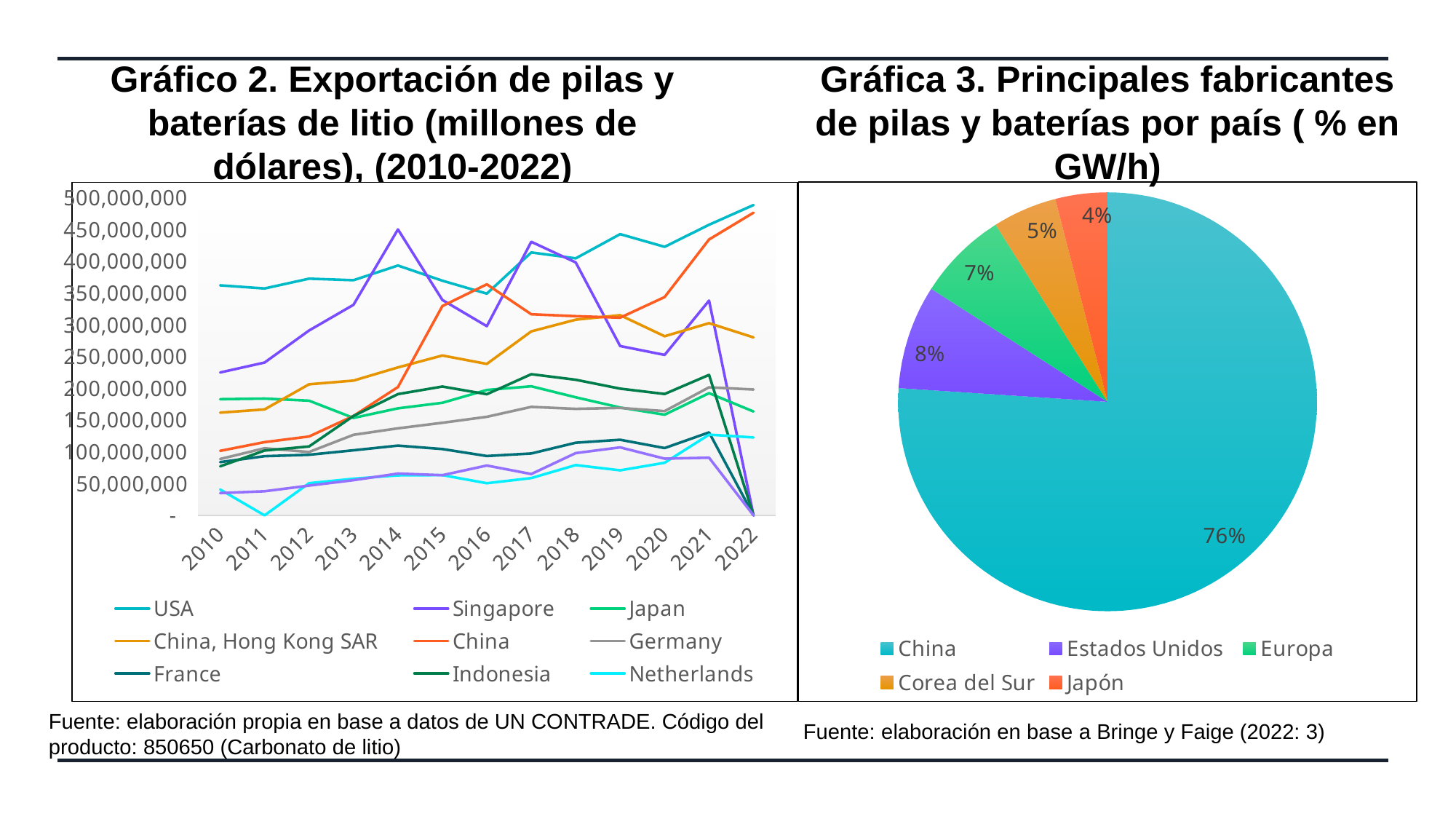
In Gráfica 3, which country has the smallest slice? Japón How many slices does the pie chart in Gráfica 3 have? 5 In Gráfico 2, is the value for Netherlands in 2011 greater or less than 50,000,000? less In Gráfico 2, is the value for USA in 2010 greater or less than 300,000,000? greater In Gráfica 3, what share of the pie does China hold? 76% How many series does the legend of Gráfico 2 list? 9 In Gráfico 2, which country has the highest value in 2010? USA In Gráfica 3, what is the difference in percentage points between China and Estados Unidos? 68 In Gráfica 3, what percentage is shown for Estados Unidos? 8% In Gráfica 3, which is larger, the share for Europa or for Corea del Sur? Europa What type of chart is Gráfico 2? Line chart In Gráfica 3, which category has the largest slice? China